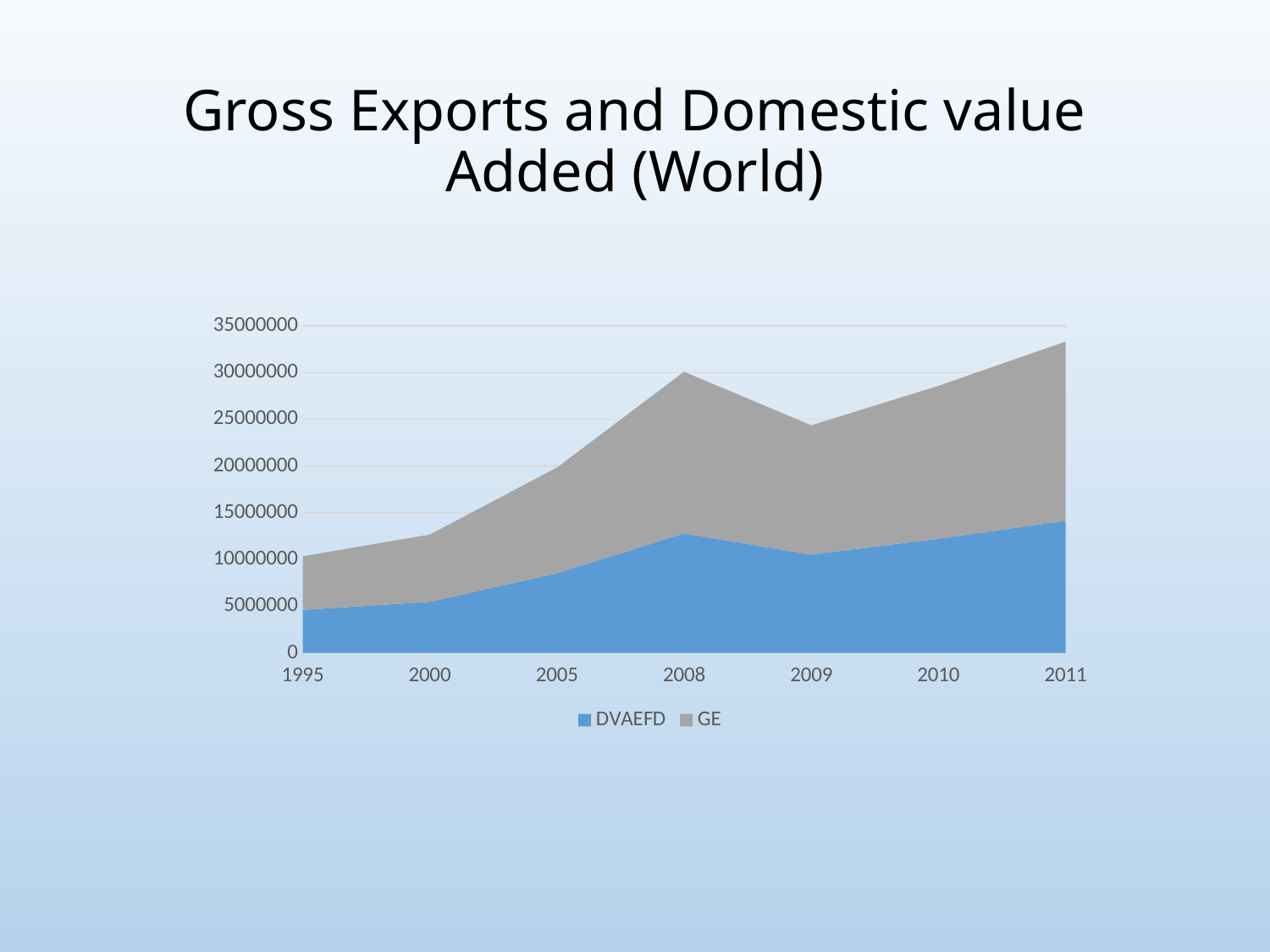
Which year has the larger DVAEFD value, 2008 or 2009? 2008 How many years are shown along the x axis? 7 Which series is shown in blue? DVAEFD Is the stacked total for 2010 greater or less than 25000000? greater Is the value for DVAEFD in 2011 greater or less than 10000000? greater What kind of chart is shown on the slide? Stacked area chart Does the DVAEFD value rise or fall from 1995 to 2008? Rise How many series does the legend list? 2 In which year is the DVAEFD value lowest? 1995 What is the title of the chart? Gross Exports and Domestic value Added (World) Is the stacked total for 2011 greater or less than 30000000? greater